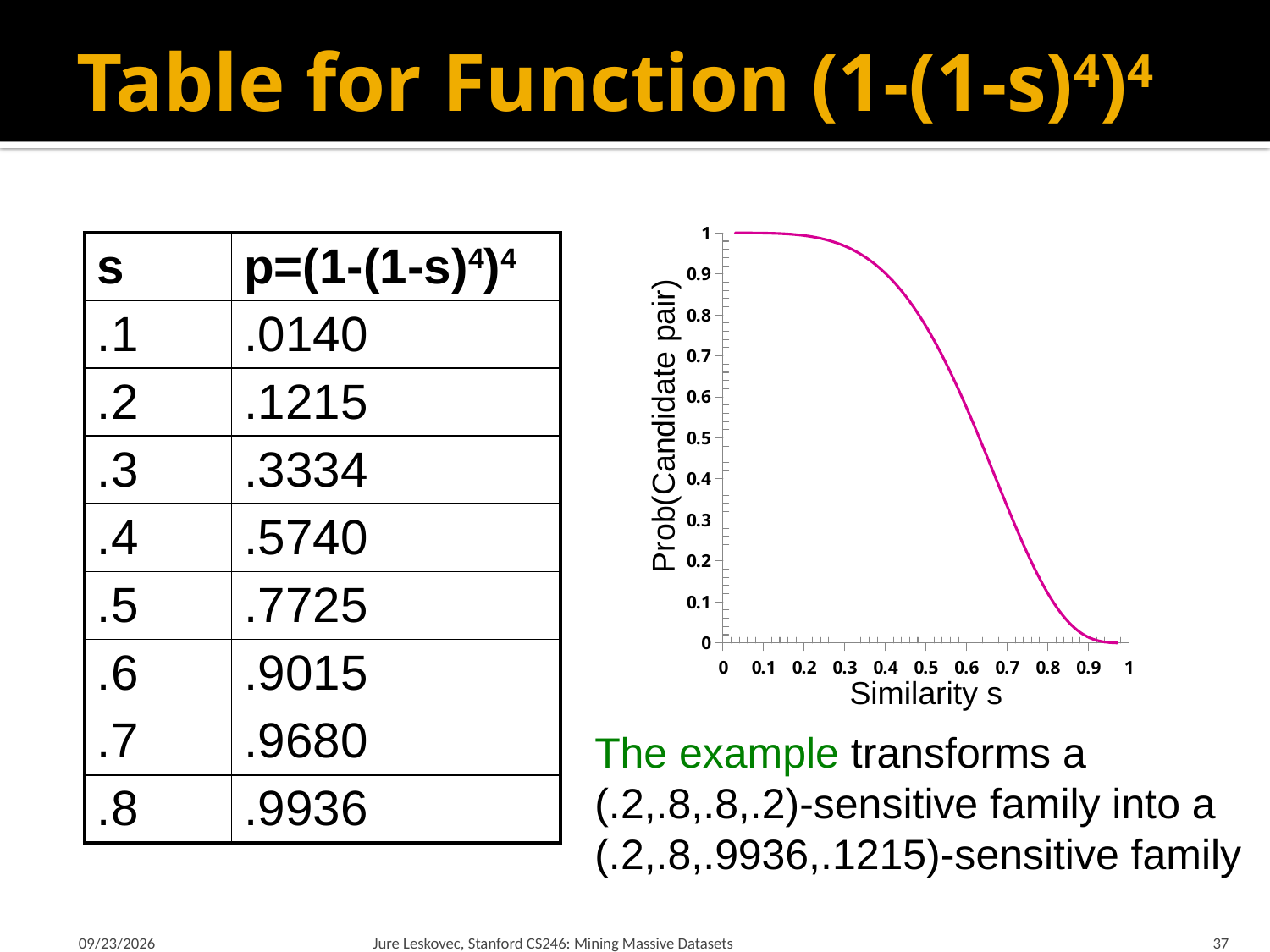
Is the value of the curve at Similarity s = 0.7 greater or less than 0.5? less Is the value of the curve at Similarity s = 0.8 greater or less than 0.3? less Is the value of the curve at Similarity s = 0.2 greater or less than 0.9? greater Which has the larger value on the curve: Similarity s = 0.2 or Similarity s = 0.8? 0.2 Which has the smaller value on the curve: Similarity s = 0.4 or Similarity s = 0.9? 0.9 What is the label of the x axis of the chart? Similarity s What is the label of the y axis of the chart? Prob(Candidate pair) What kind of chart is shown on the slide? line chart Does the plotted curve rise or fall as Similarity s increases from 0 to 1? fall